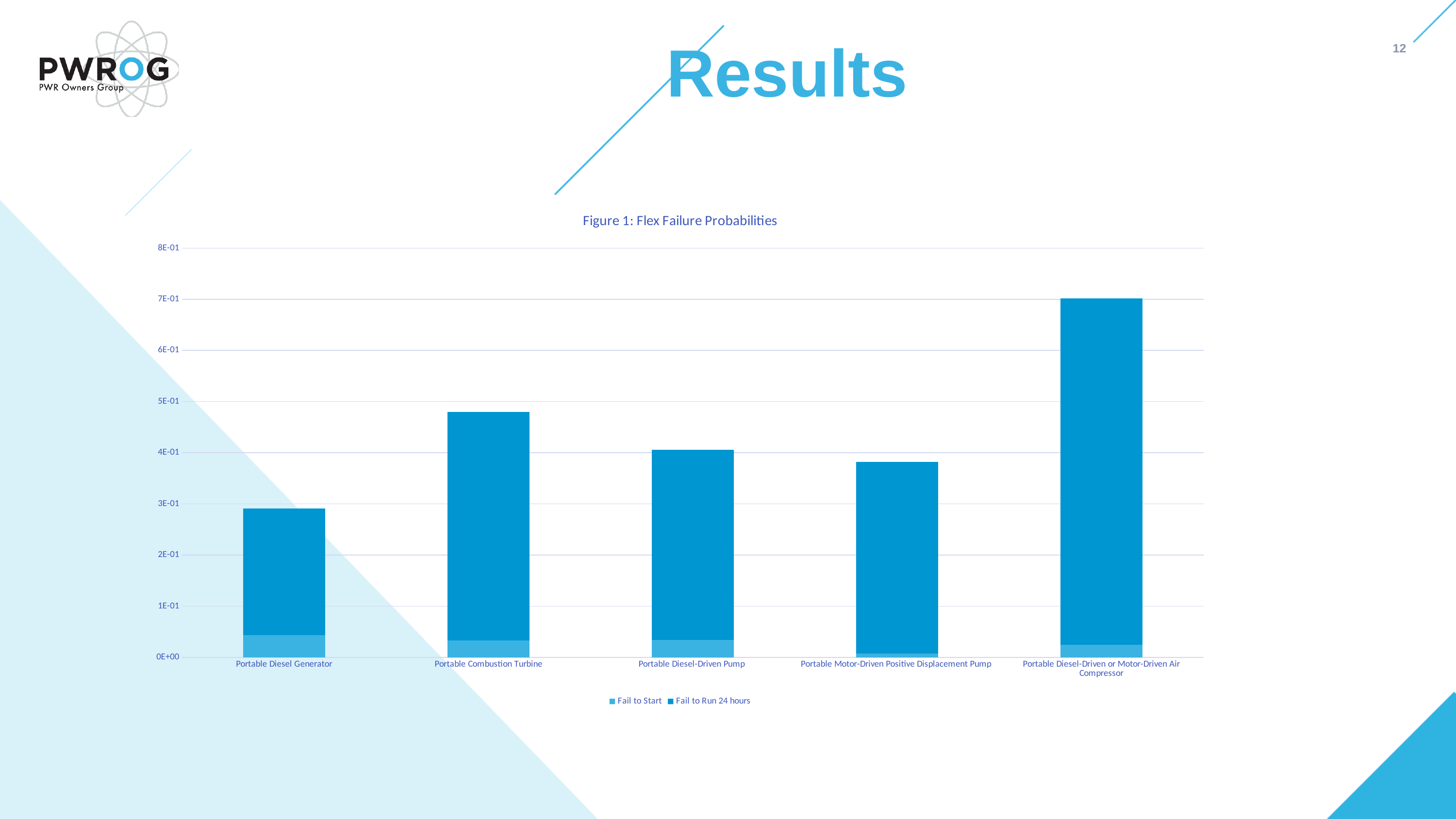
Which category has the highest total failure probability? Portable Diesel-Driven or Motor-Driven Air Compressor Is the total value for Portable Combustion Turbine greater or less than 5E-01? less Which category has the lowest total failure probability? Portable Diesel Generator What are the two series named in the legend? Fail to Start; Fail to Run 24 hours Which category has the smallest Fail to Start segment? Portable Motor-Driven Positive Displacement Pump Is the total value for Portable Diesel-Driven or Motor-Driven Air Compressor greater or less than 6E-01? greater What is the title of the chart? Figure 1: Flex Failure Probabilities Which has the larger total failure probability, Portable Combustion Turbine or Portable Diesel-Driven Pump? Portable Combustion Turbine How many equipment categories are shown on the x axis? 5 What kind of chart is shown on the slide? Stacked bar chart How many series does the legend list? 2 Is the total value for Portable Motor-Driven Positive Displacement Pump greater or less than 4E-01? less